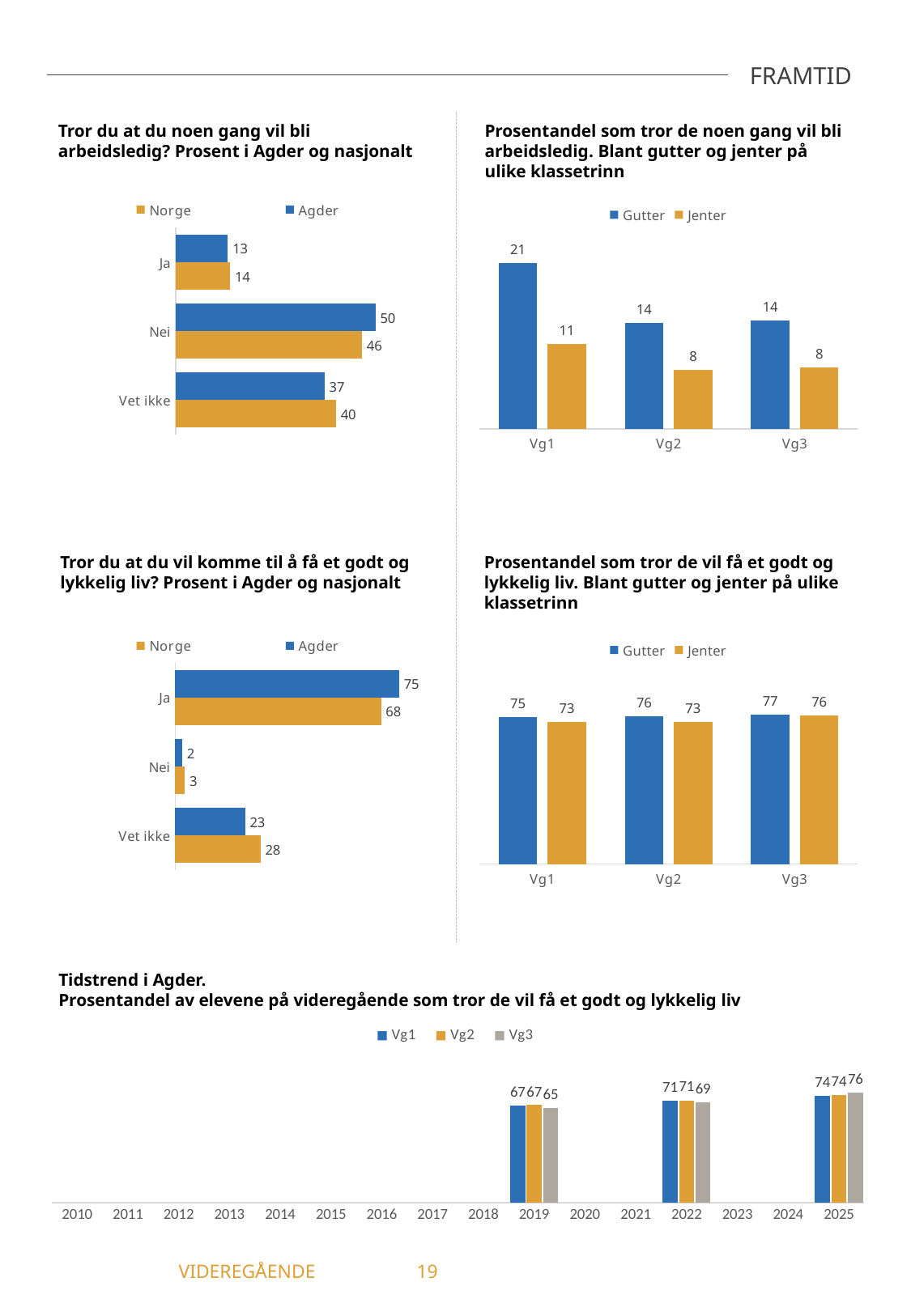
In the middle-right chart 'Prosentandel som tror de vil få et godt og lykkelig liv', what is the difference between Gutter and Jenter at Vg2? 3 What kind of chart is the middle-left chart 'Tror du at du vil komme til å få et godt og lykkelig liv?'? Bar chart In the bottom chart 'Tidstrend i Agder', what is the value for Vg3 in 2025? 76 In the top-right chart 'Prosentandel som tror de noen gang vil bli arbeidsledig', which class level has the highest value for Jenter? Vg1 In the middle-left chart 'Tror du at du vil komme til å få et godt og lykkelig liv?', which is larger for 'Vet ikke': Norge or Agder? Norge In the middle-right chart 'Prosentandel som tror de vil få et godt og lykkelig liv', what is the value for Jenter at Vg3? 76 In the top-right chart 'Prosentandel som tror de noen gang vil bli arbeidsledig', what is the value for Gutter at Vg1? 21 In the top-right chart 'Prosentandel som tror de noen gang vil bli arbeidsledig', how many series does the legend list? 2 In the top-left chart 'Tror du at du noen gang vil bli arbeidsledig?', what is the value for Agder for 'Nei'? 50 In the top-left chart 'Tror du at du noen gang vil bli arbeidsledig?', what is the difference between the Norge and Agder values for 'Vet ikke'? 3 In the bottom chart 'Tidstrend i Agder', do the Vg1 values rise or fall from 2019 to 2025? Rise In the middle-left chart 'Tror du at du vil komme til å få et godt og lykkelig liv?', what is the value for Norge for 'Ja'? 68